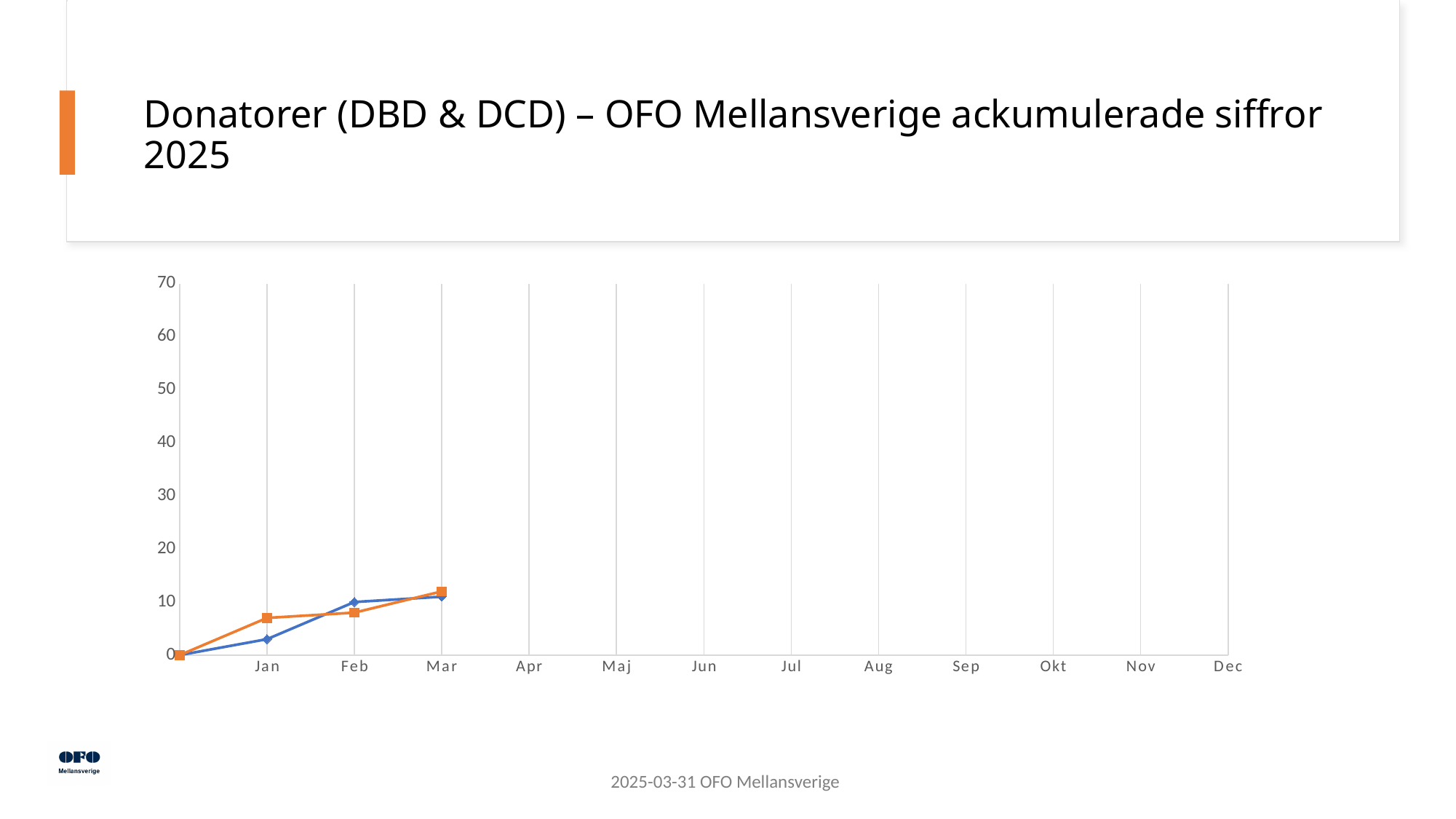
Do the values of the orange line rise or fall from Jan to Mar? rise Is the value of the blue line at Feb greater or less than 20? less How many lines are plotted on the chart? 2 What kind of chart is shown on the slide? line chart Is the value of the blue line at Jan greater or less than 10? less Is the value of the orange line at Mar greater or less than 20? less At Jan, which line has the higher value, the blue line or the orange line? orange line What is the highest value shown on the y axis of the chart? 70 How many month labels are shown on the x axis of the chart? 12 At Feb, which line has the higher value, the blue line or the orange line? blue line Do the values of the blue line rise or fall from Jan to Mar? rise